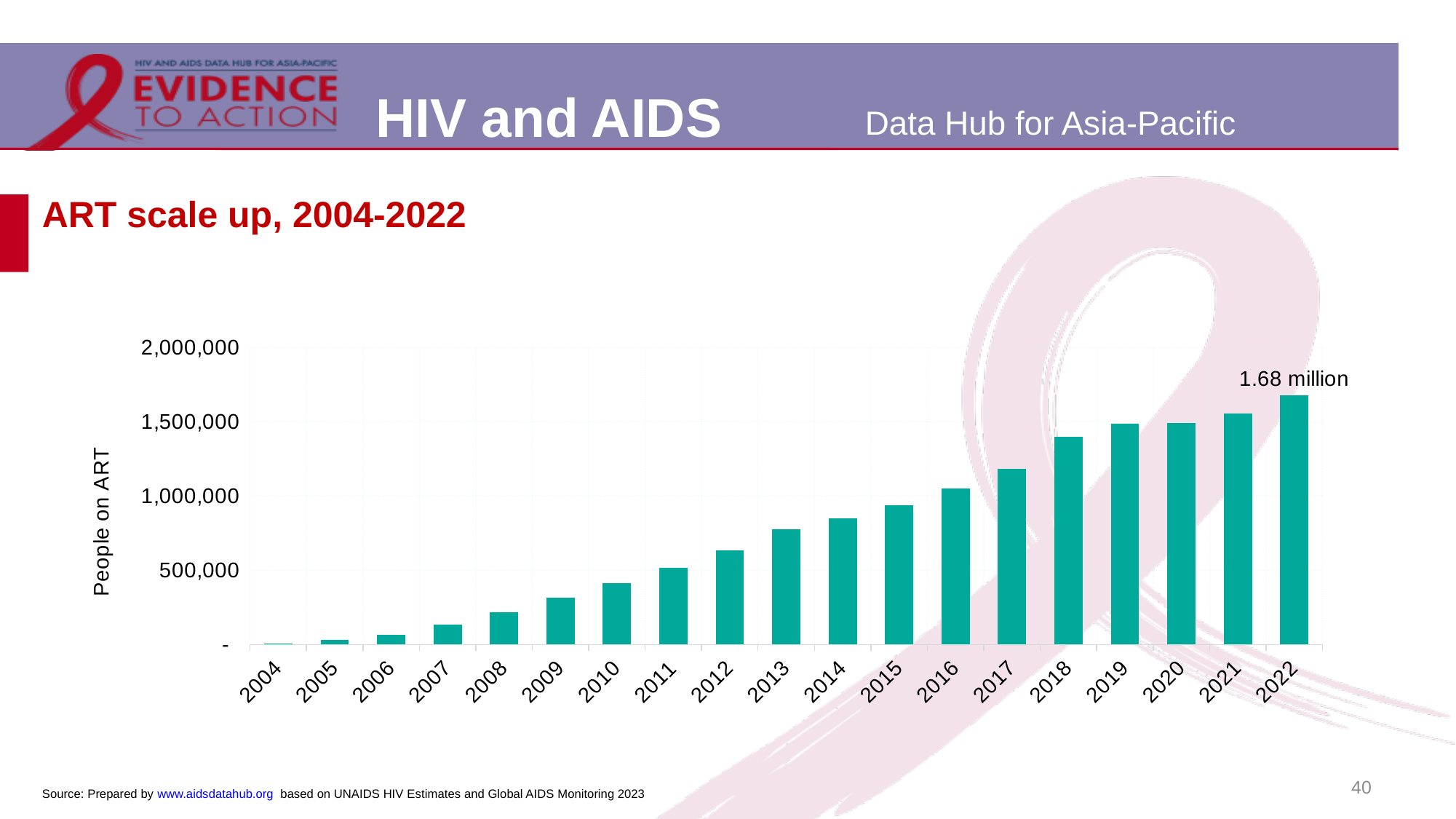
What kind of chart is shown on the slide? bar chart Which year has more people on ART, 2012 or 2018? 2018 What is the label on the vertical axis of the chart? People on ART Is the value for 2010 greater or less than 500,000? less Is the value for 2017 greater or less than 1,000,000? greater Do the values rise or fall from 2004 to 2022? rise How many people were on ART in 2022 according to the data label? 1.68 million Which year has the highest number of people on ART? 2022 How many years (bars) are shown on the chart? 19 Is the value for 2018 greater or less than 1,500,000? less What is the title of the chart? ART scale up, 2004-2022 Which year has the lowest number of people on ART? 2004